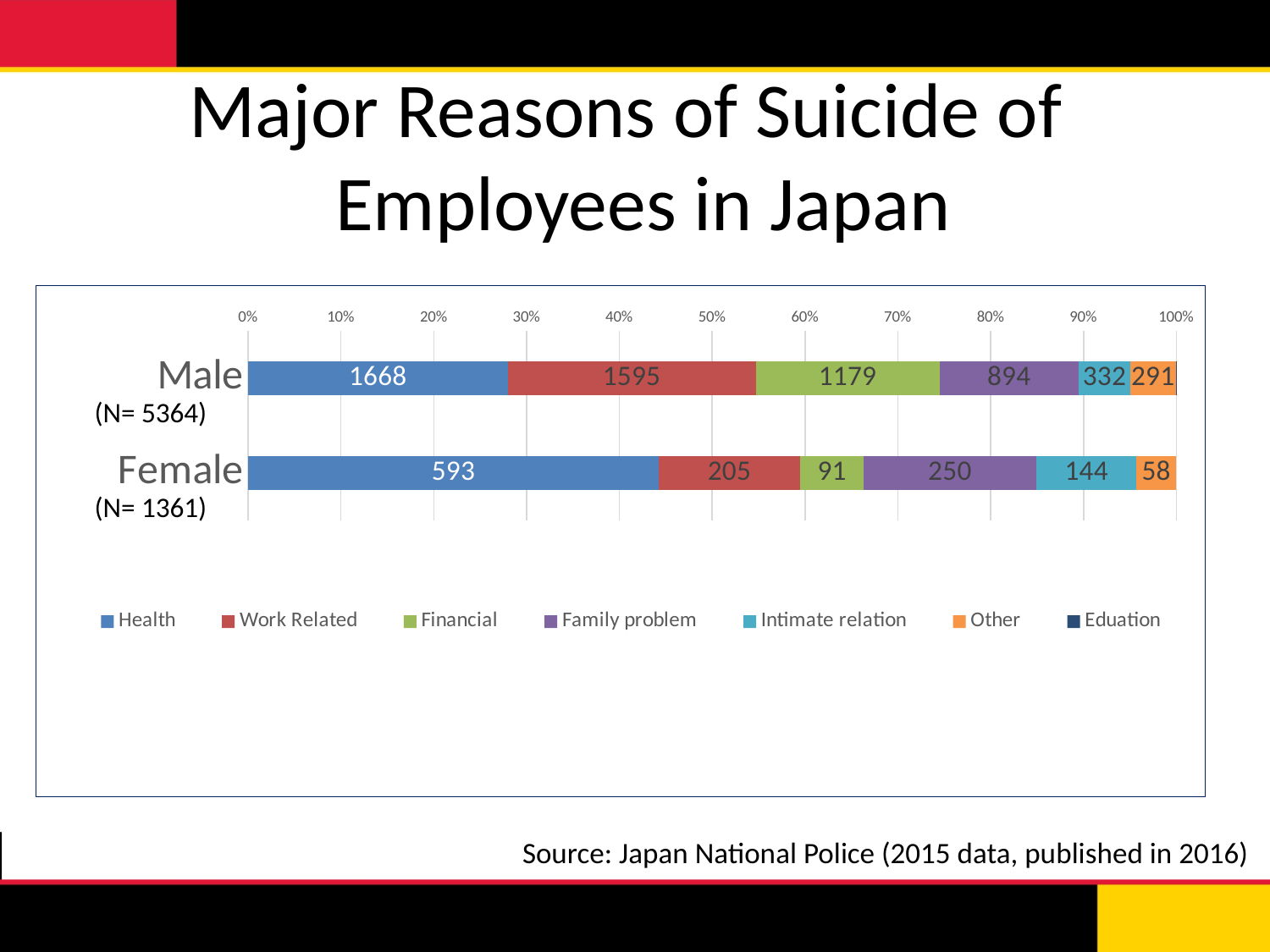
Is the share of the Male bar taken by Health greater or less than 30%? less What is the difference between the Health values for Male and Female? 1075 Which is larger for Female: Family problem or Work Related? Family problem Which reason has the largest value for Female? Health How many series does the legend list? 7 What is the Work Related value for Female? 205 What is the Intimate relation value for Female? 144 What is the Health value for Male? 1668 What kind of chart is shown on the slide? Stacked bar chart How many categories (bars) are shown in the chart? 2 What is the Family problem value for Male? 894